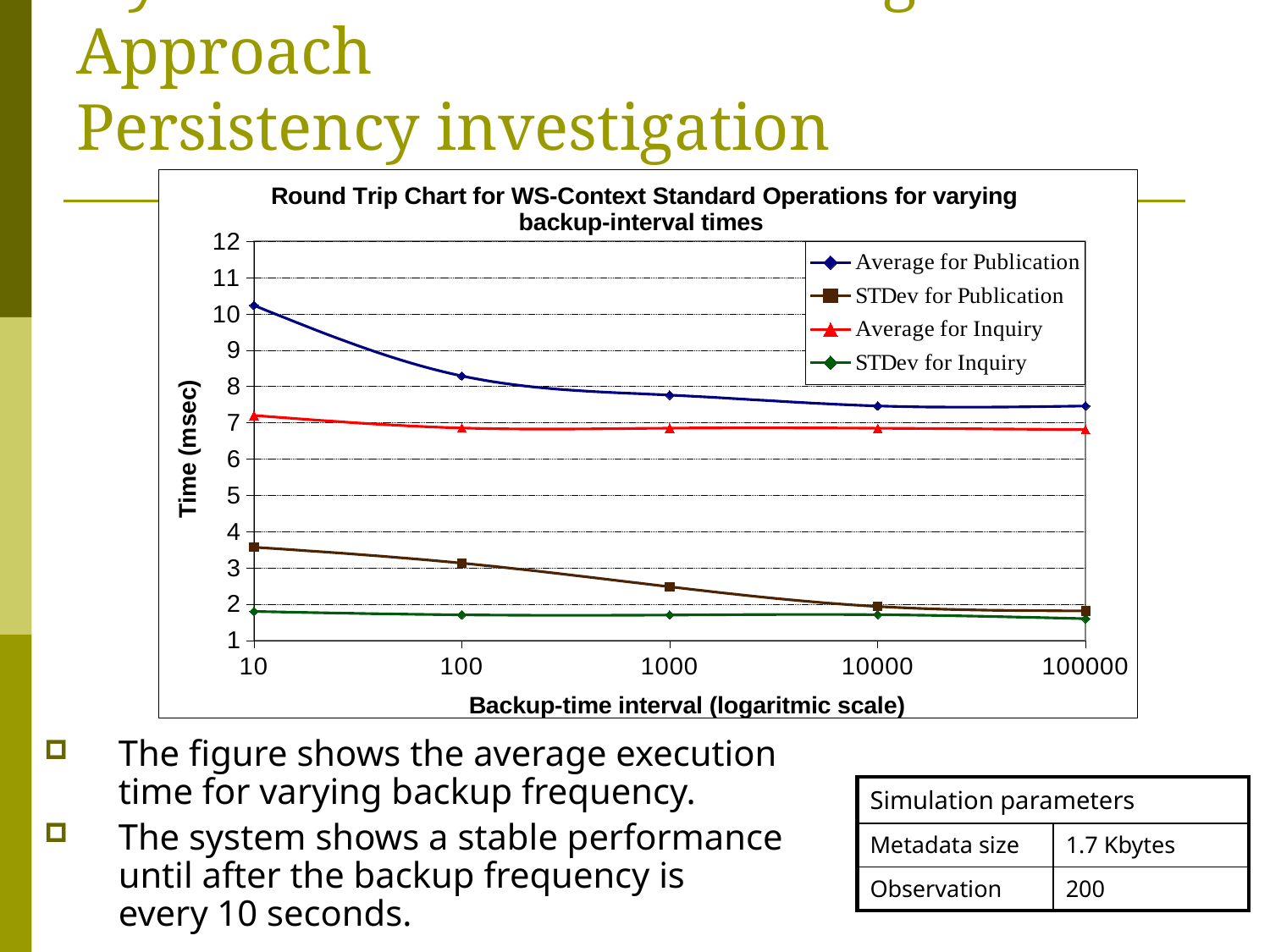
Is the value of Average for Inquiry at a backup-time interval of 100 greater or less than 7? less What kind of chart is shown on the slide? line chart Is the value of STDev for Inquiry at a backup-time interval of 1000 greater or less than 2? less How many backup-time interval values are plotted along the x axis? 5 How many series does the legend list? 4 Is the value of Average for Publication at a backup-time interval of 10 greater or less than 10? greater Which series has the highest value at a backup-time interval of 10? Average for Publication What is the label of the y axis? Time (msec) Does the STDev for Publication series rise or fall as the backup-time interval increases? fall At a backup-time interval of 10, which is larger: Average for Publication or Average for Inquiry? Average for Publication Does the Average for Publication series rise or fall as the backup-time interval increases? fall